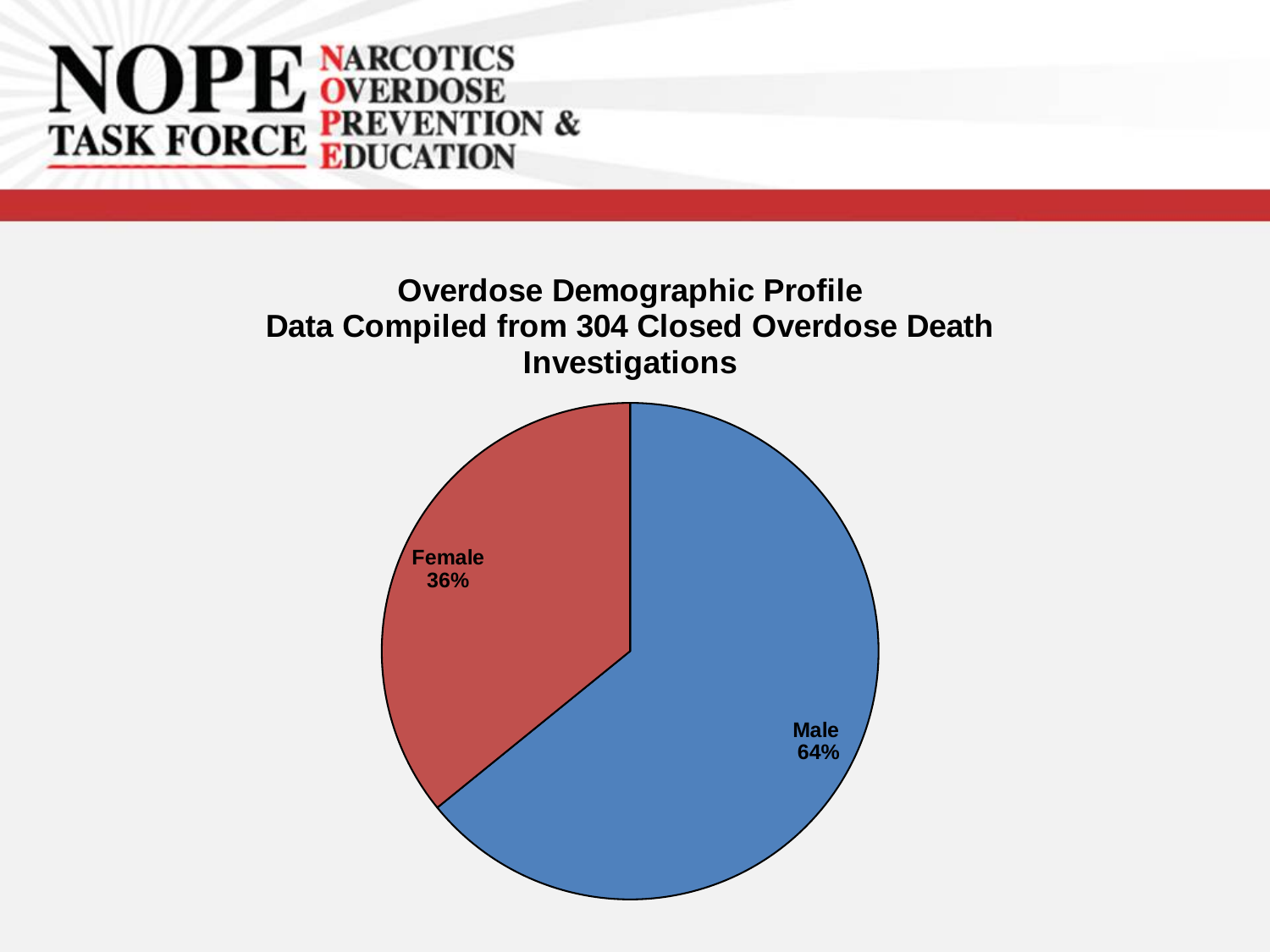
Which is larger, the Male slice or the Female slice? Male What share of the pie is Male? 64% Which slice is the largest? Male How many closed overdose death investigations does the chart title say the data was compiled from? 304 What kind of chart is shown on the slide? pie chart What is the difference in percentage points between the Male and Female slices? 28 What is the title of the chart? Overdose Demographic Profile Data Compiled from 304 Closed Overdose Death Investigations What share of the pie is Female? 36% What colour is the Female slice? red How many slices does the pie chart have? 2 Which slice is the smallest? Female